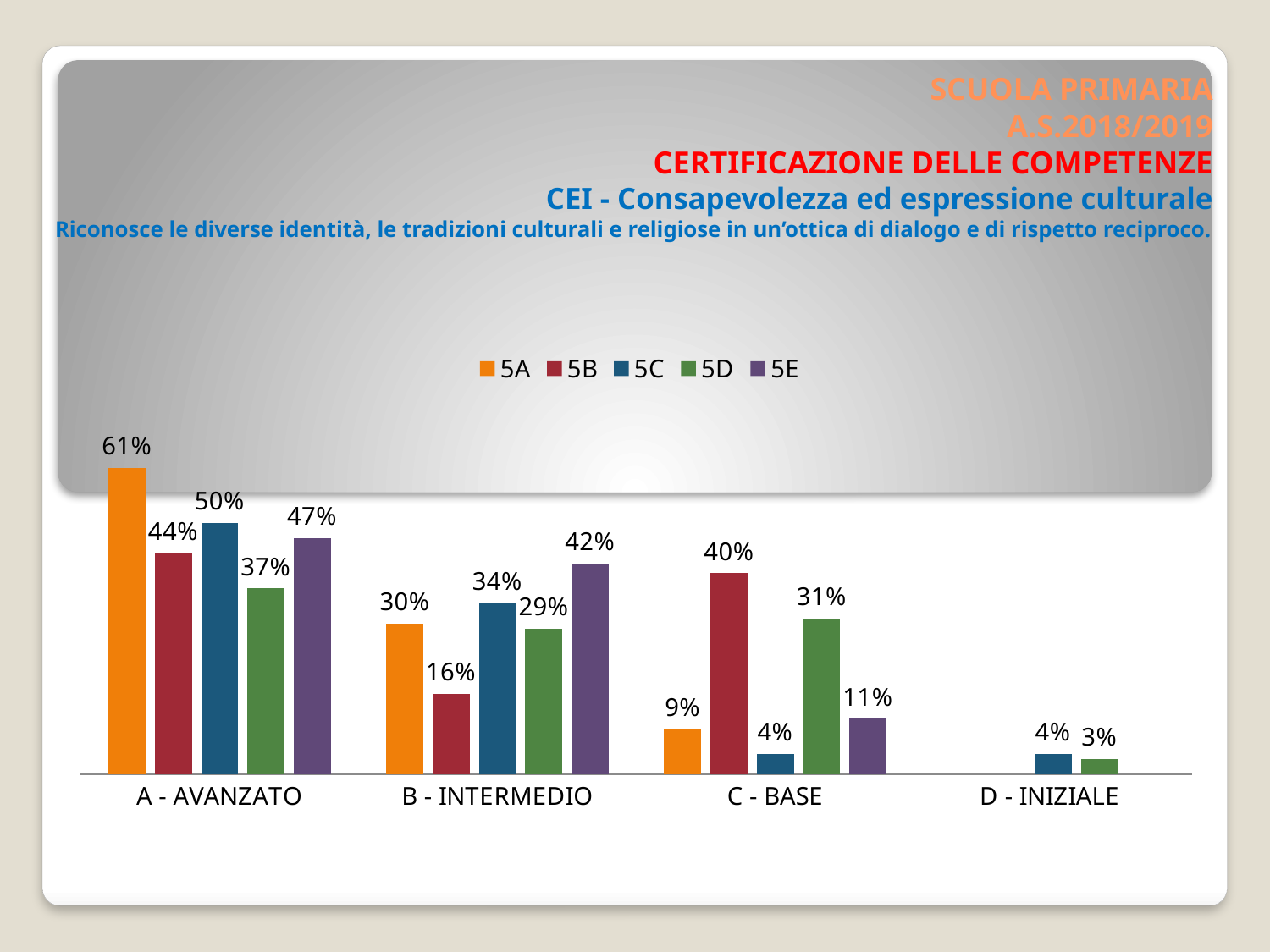
Which is larger in the B - INTERMEDIO category, the value for 5A or the value for 5C? 5C What is the difference between the 5B and 5C values in the C - BASE category? 36% What kind of chart is shown on the slide? Bar chart What is the value for 5B in the C - BASE category? 40% Which series is shown in orange in the legend? 5A Which series has the highest value in the A - AVANZATO category? 5A How many series does the legend list? 5 What is the value for 5E in the B - INTERMEDIO category? 42% Which series has the lowest value in the B - INTERMEDIO category? 5B How many categories are shown on the x axis? 4 What is the value for 5A in the A - AVANZATO category? 61% What is the value for 5D in the D - INIZIALE category? 3%